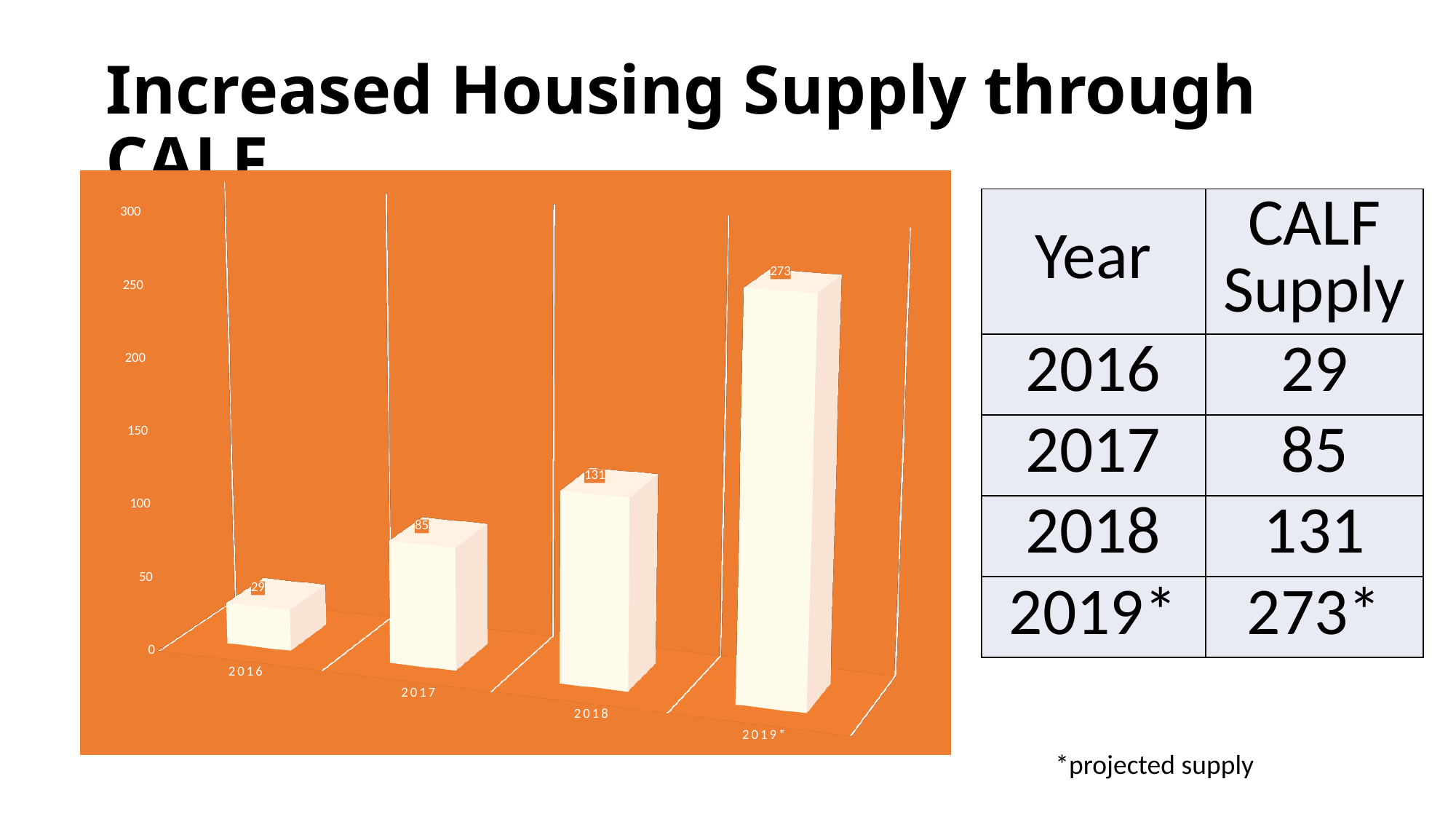
What is the value for 2018 in the chart? 131 How many years are shown on the x axis of the chart? 4 What is the value for 2017 in the chart? 85 Which year has the highest value in the chart? 2019* What kind of chart is shown on the slide? bar chart What is the difference between the values for 2017 and 2016? 56 What is the difference between the values for 2019* and 2018? 142 Which is larger, the value for 2017 or the value for 2018? 2018 Do the values rise or fall from 2016 to 2019*? rise Which year has the lowest value in the chart? 2016 What is the value for 2016 in the chart? 29 What is the value for 2019* in the chart? 273